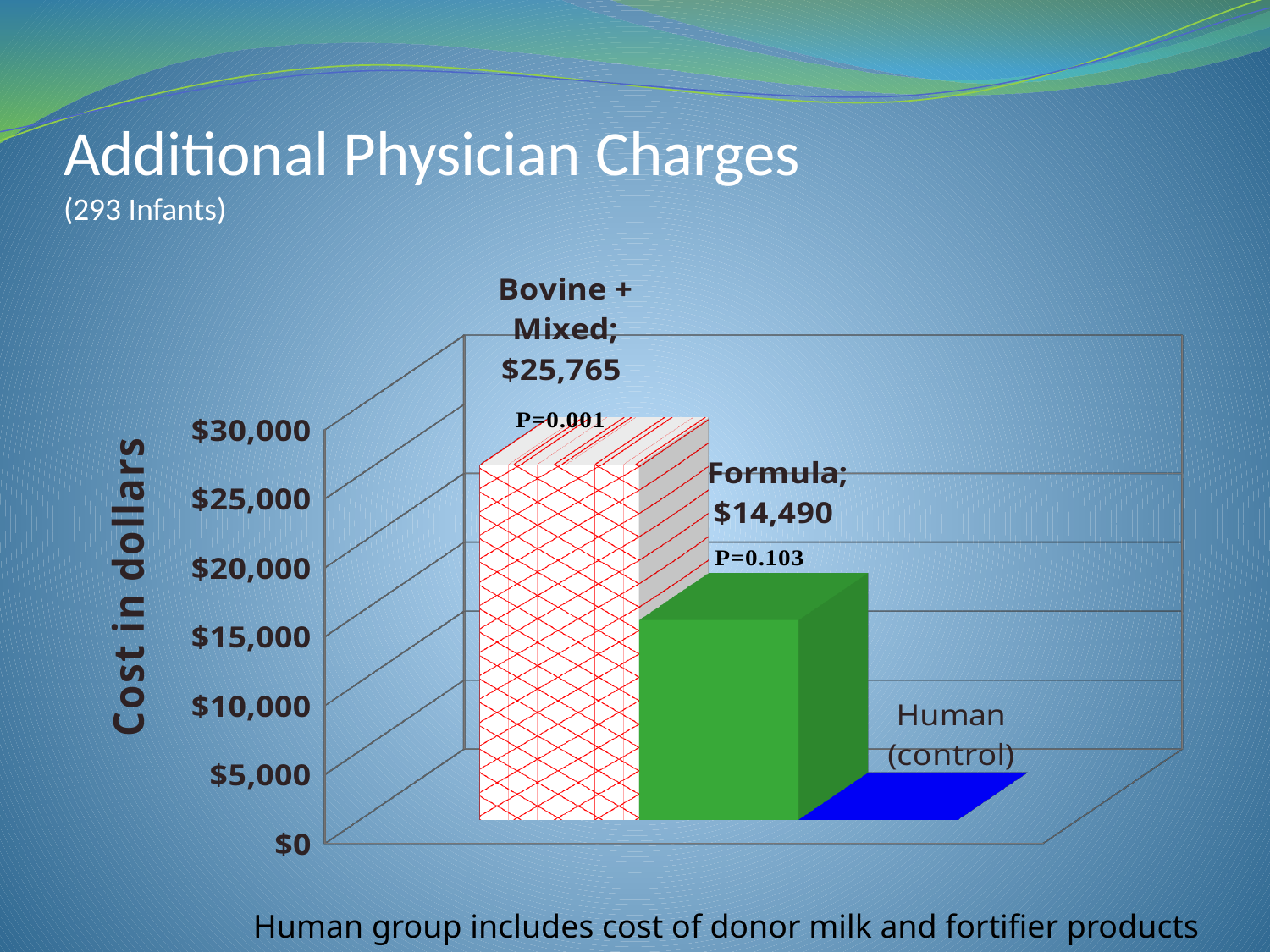
What is the value for Bovine + Mixed? $25,765 Is the value for Human (control) greater or less than $5,000? less What is the title of the slide? Additional Physician Charges Which category has the lowest cost? Human (control) What is the difference between the Bovine + Mixed and Formula values? $11,275 What is the value for Formula? $14,490 What P-value is printed above the Bovine + Mixed bar? P=0.001 Is the value for Formula greater or less than $10,000? greater Which is larger, the value for Formula or the value for Human (control)? Formula Which category has the highest cost? Bovine + Mixed What kind of chart is shown on the slide? bar chart How many categories are shown in the chart? 3